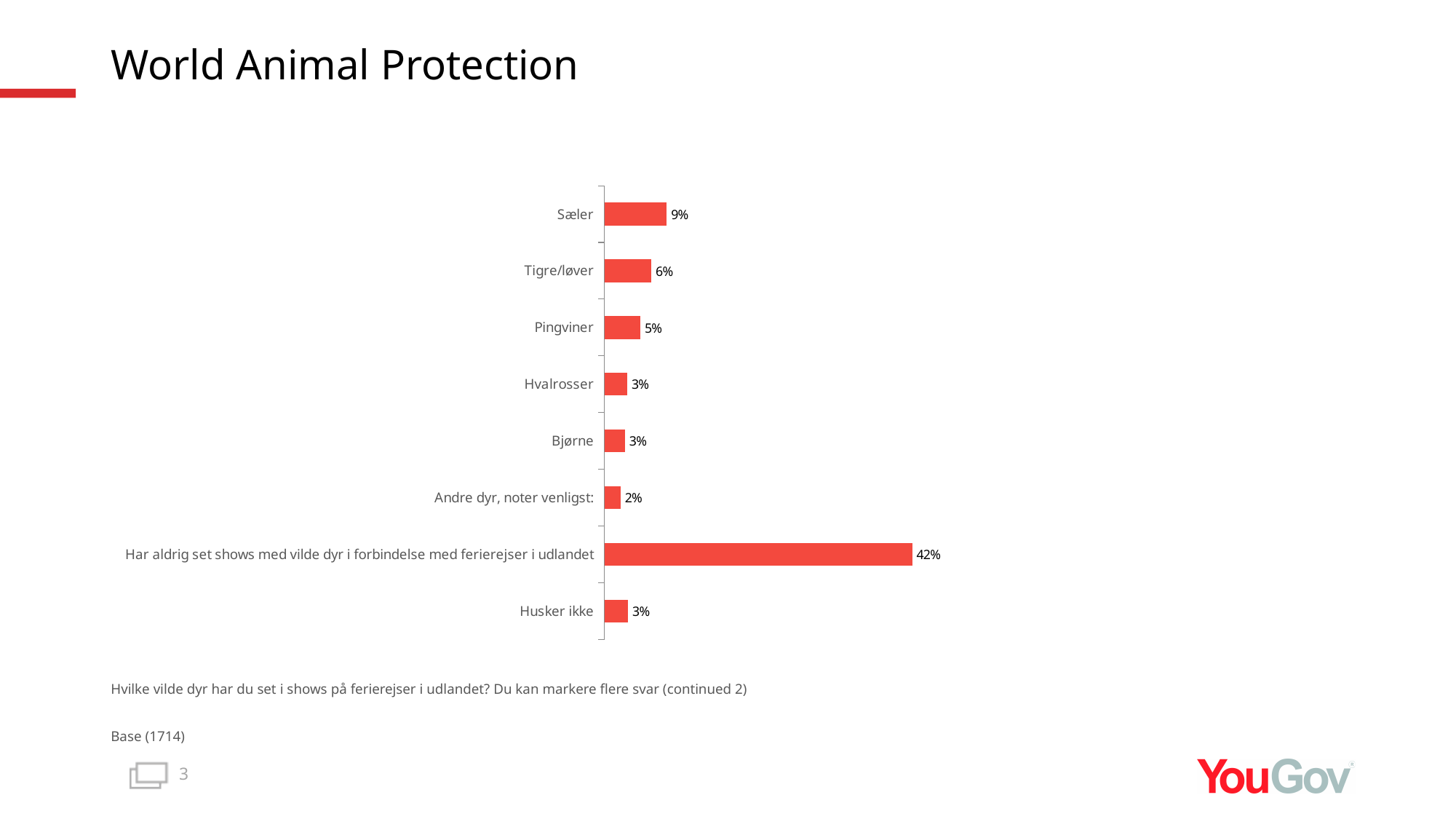
What percentage is shown for Sæler? 9% Which category has the highest value? Har aldrig set shows med vilde dyr i forbindelse med ferierejser i udlandet What is the difference between the values for Sæler and Tigre/løver? 3% What is the difference between the value for 'Har aldrig set shows med vilde dyr i forbindelse med ferierejser i udlandet' and Sæler? 33% What kind of chart is shown on the slide? Bar chart What percentage is shown for Pingviner? 5% Which is larger, the value for Pingviner or the value for Hvalrosser? Pingviner What is the value for Tigre/løver? 6% What is the value for 'Har aldrig set shows med vilde dyr i forbindelse med ferierejser i udlandet'? 42% Which category has the lowest value? Andre dyr, noter venligst: What is the base (number of respondents) stated on the slide? 1714 How many categories are shown in the chart? 8